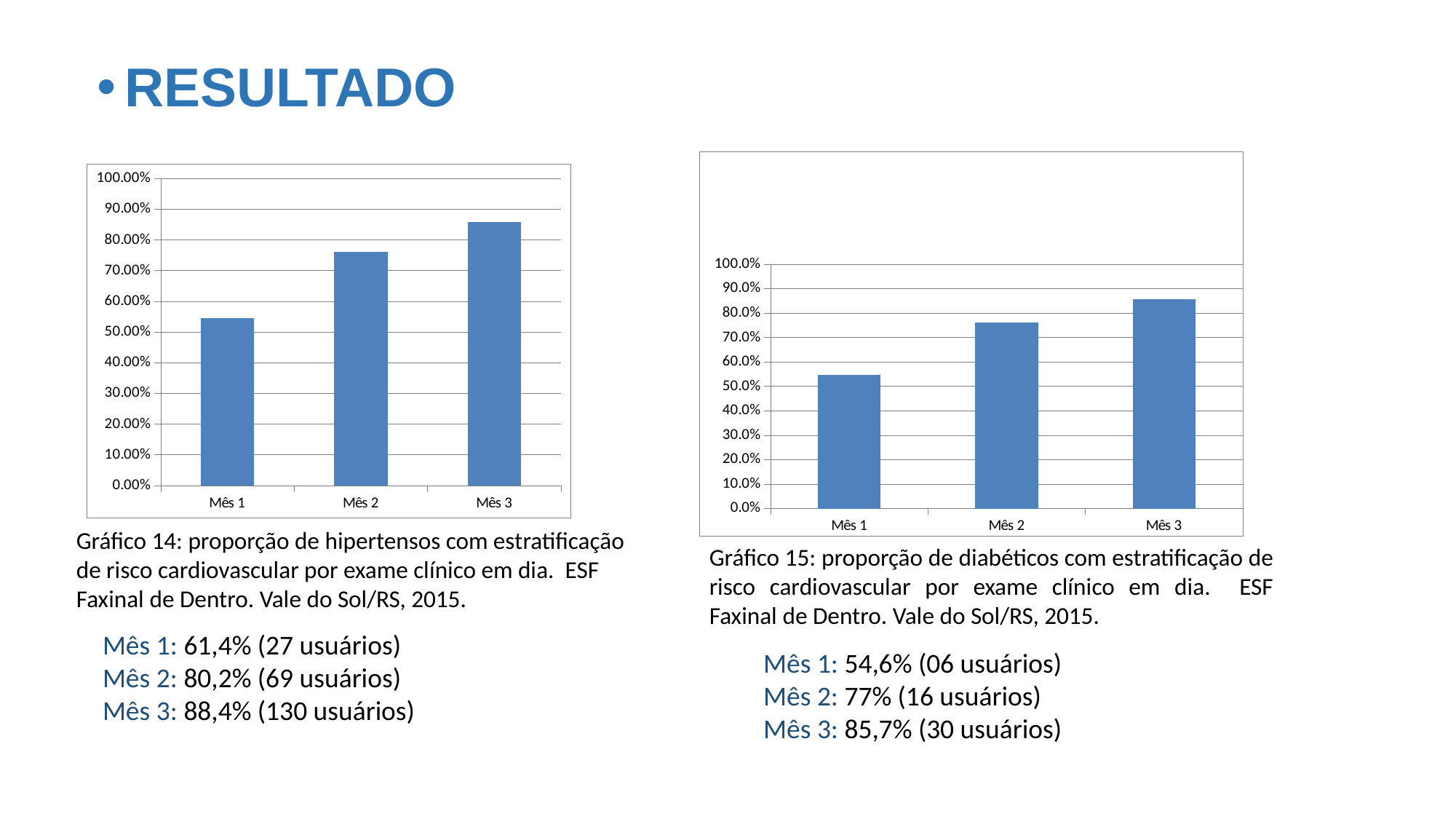
In Gráfico 15 (the right chart), is the value for Mês 1 greater or less than 50.0%? greater What is the maximum value shown on the y axis of Gráfico 15 (the right chart)? 100.0% In Gráfico 15 (the right chart), which month has the lowest bar? Mês 1 In Gráfico 15 (the right chart), is the value for Mês 3 greater or less than 90.0%? less In Gráfico 14 (the left chart), do the values rise or fall from Mês 1 to Mês 3? rise In Gráfico 14 (the left chart), which month has the highest bar? Mês 3 How many categories are shown on the x axis of Gráfico 15 (the right chart)? 3 In Gráfico 15 (the right chart), which is larger, the value for Mês 1 or the value for Mês 2? Mês 2 In Gráfico 14 (the left chart), is the value for Mês 3 greater or less than 80.00%? greater What kind of chart is Gráfico 14 (the left chart)? bar chart